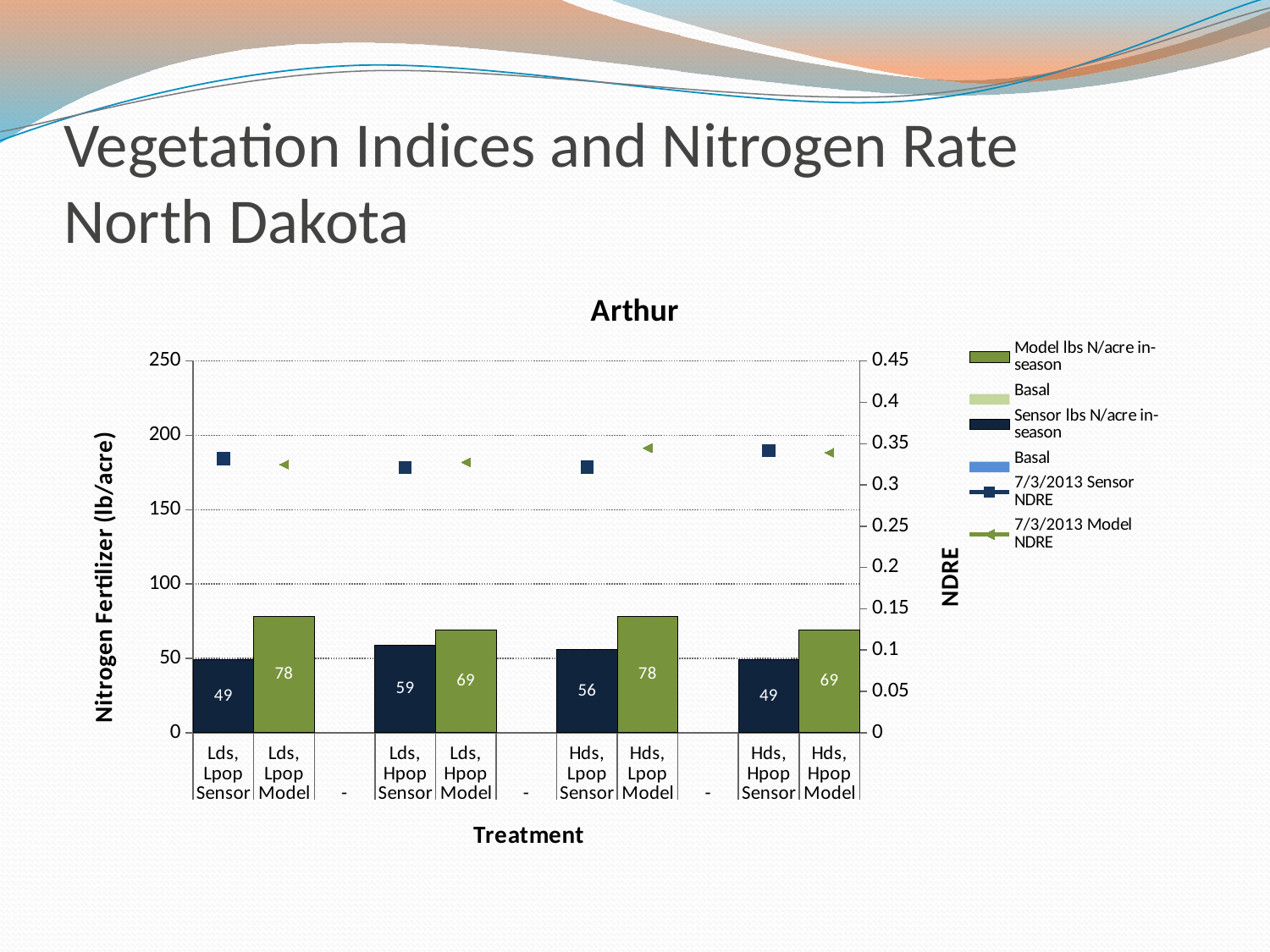
What is the difference between the Model and Sensor lbs N/acre in-season values for the Lds, Lpop treatment? 29 What is the Model lbs N/acre in-season value for the Hds, Lpop treatment? 78 Is the 7/3/2013 Model NDRE value for the Lds, Lpop treatment greater or less than 0.3? greater What is the Sensor lbs N/acre in-season value for the Lds, Lpop treatment? 49 What is the Sensor lbs N/acre in-season value for the Lds, Hpop treatment? 59 What is the Model lbs N/acre in-season value for the Hds, Hpop treatment? 69 Is the 7/3/2013 Sensor NDRE value for the Lds, Hpop treatment greater or less than 0.35? less How many series does the legend list? 6 What is the label of the left vertical axis? Nitrogen Fertilizer (lb/acre) What is the title of the chart? Arthur Which treatment has the highest Sensor lbs N/acre in-season value? Lds, Hpop Which is larger for the Hds, Lpop treatment: the Sensor lbs N/acre in-season value or the Model lbs N/acre in-season value? Model lbs N/acre in-season